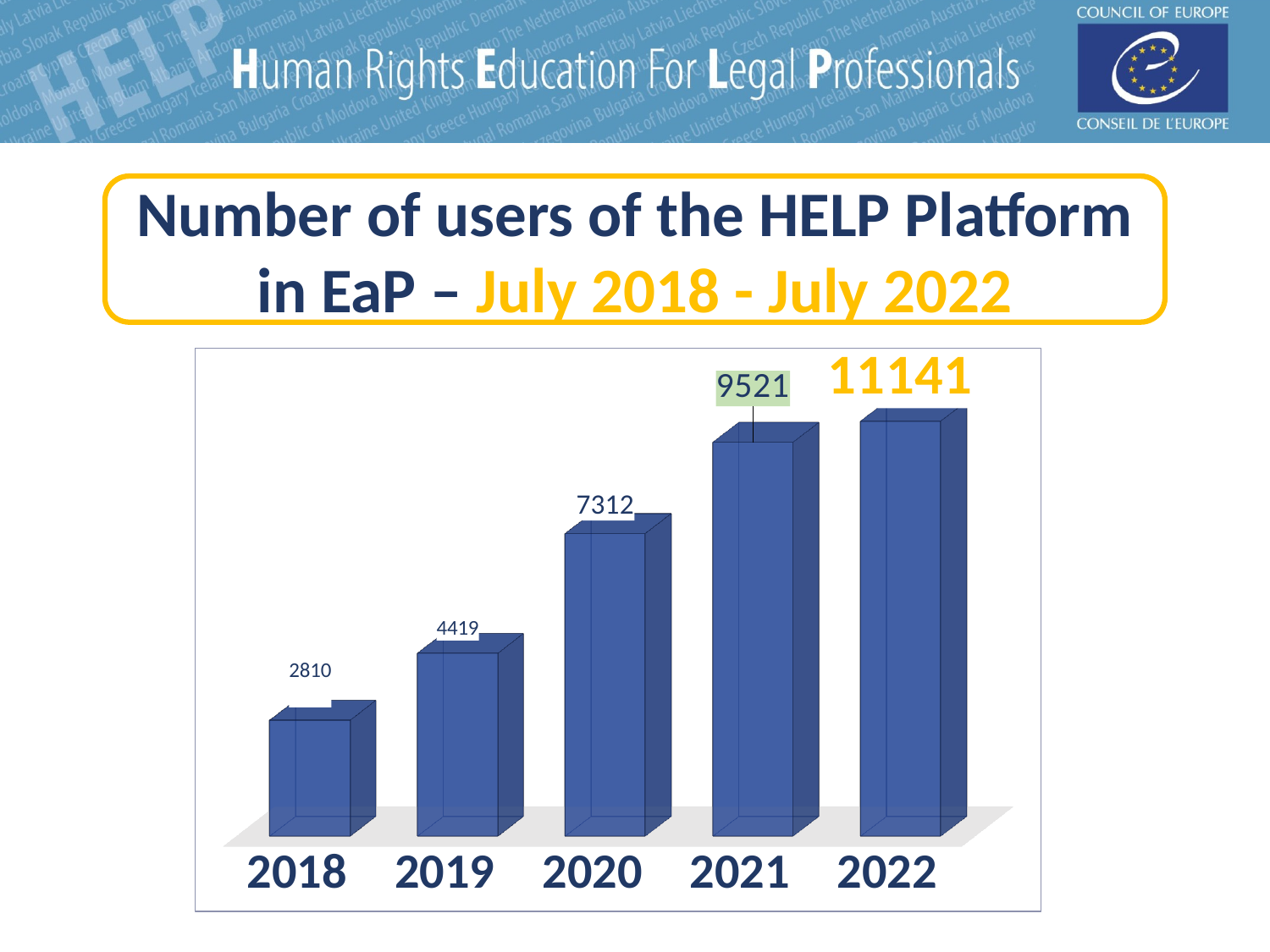
What is the number of users of the HELP Platform in EaP in 2022? 11141 What is the number of users of the HELP Platform in EaP in 2018? 2810 What kind of chart is shown on the slide? Bar chart Which year has the highest number of users? 2022 How many years are shown on the chart? 5 What is the number of users of the HELP Platform in EaP in 2020? 7312 Which year has more users, 2020 or 2021? 2021 Do the number of users rise or fall from 2018 to 2022? Rise What is the difference in the number of users between 2019 and 2018? 1609 What period does the chart title say the data covers? July 2018 - July 2022 Which year has the lowest number of users? 2018 What is the difference in the number of users between 2022 and 2021? 1620